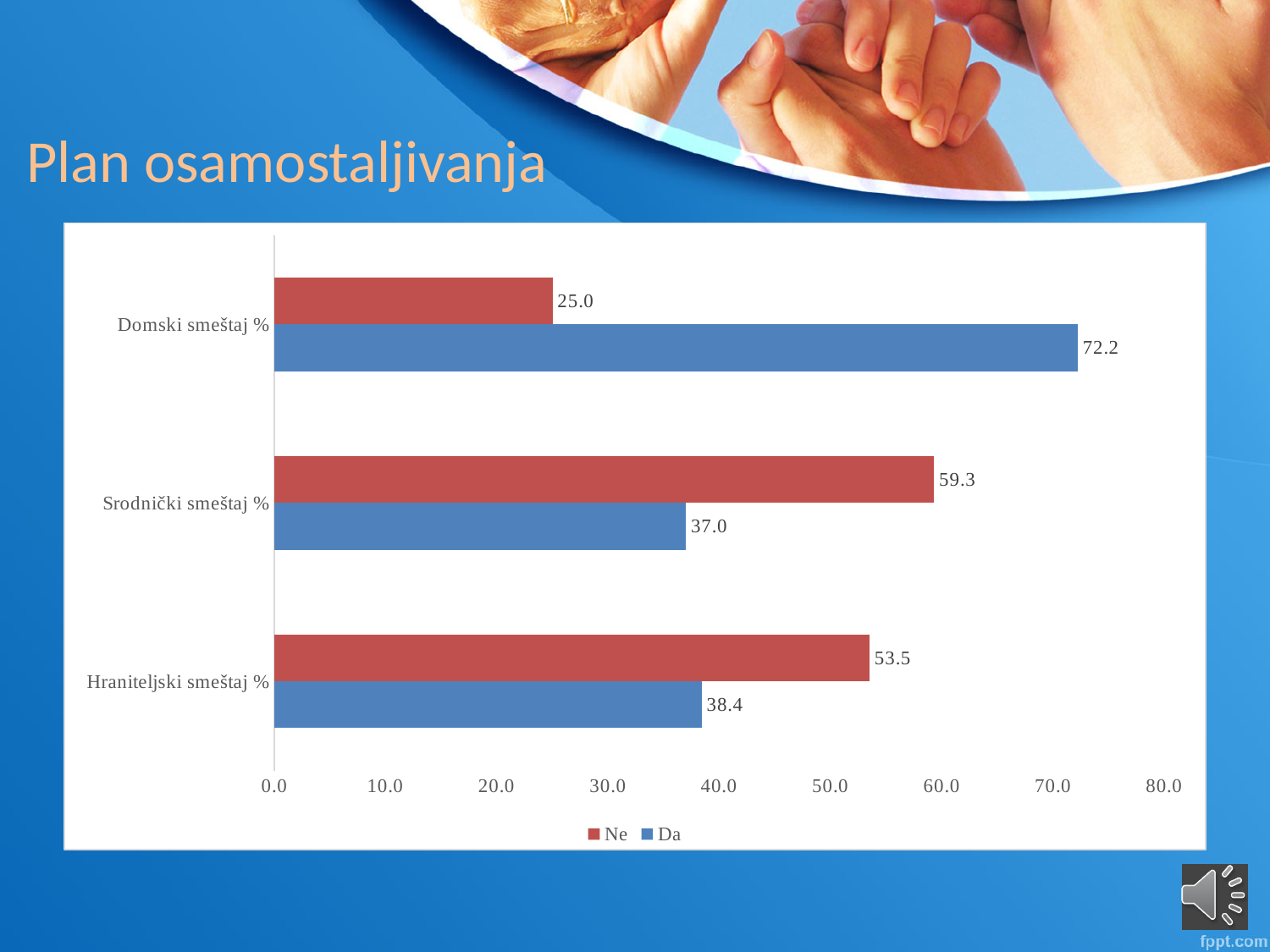
What kind of chart is shown on the slide? Bar chart For Srodnički smeštaj %, which is larger, the "Ne" value or the "Da" value? Ne How many series does the legend list? 2 How many categories are shown on the chart? 3 Which colour represents the "Ne" series in the chart? Red What is the difference between the "Da" and "Ne" values for Domski smeštaj %? 47.2 What is the value of the "Da" series for Domski smeštaj %? 72.2 What is the value of the "Ne" series for Srodnički smeštaj %? 59.3 Which category has the highest "Da" value? Domski smeštaj % Which category has the lowest "Ne" value? Domski smeštaj % What is the value of the "Ne" series for Domski smeštaj %? 25.0 What is the value of the "Da" series for Hraniteljski smeštaj %? 38.4